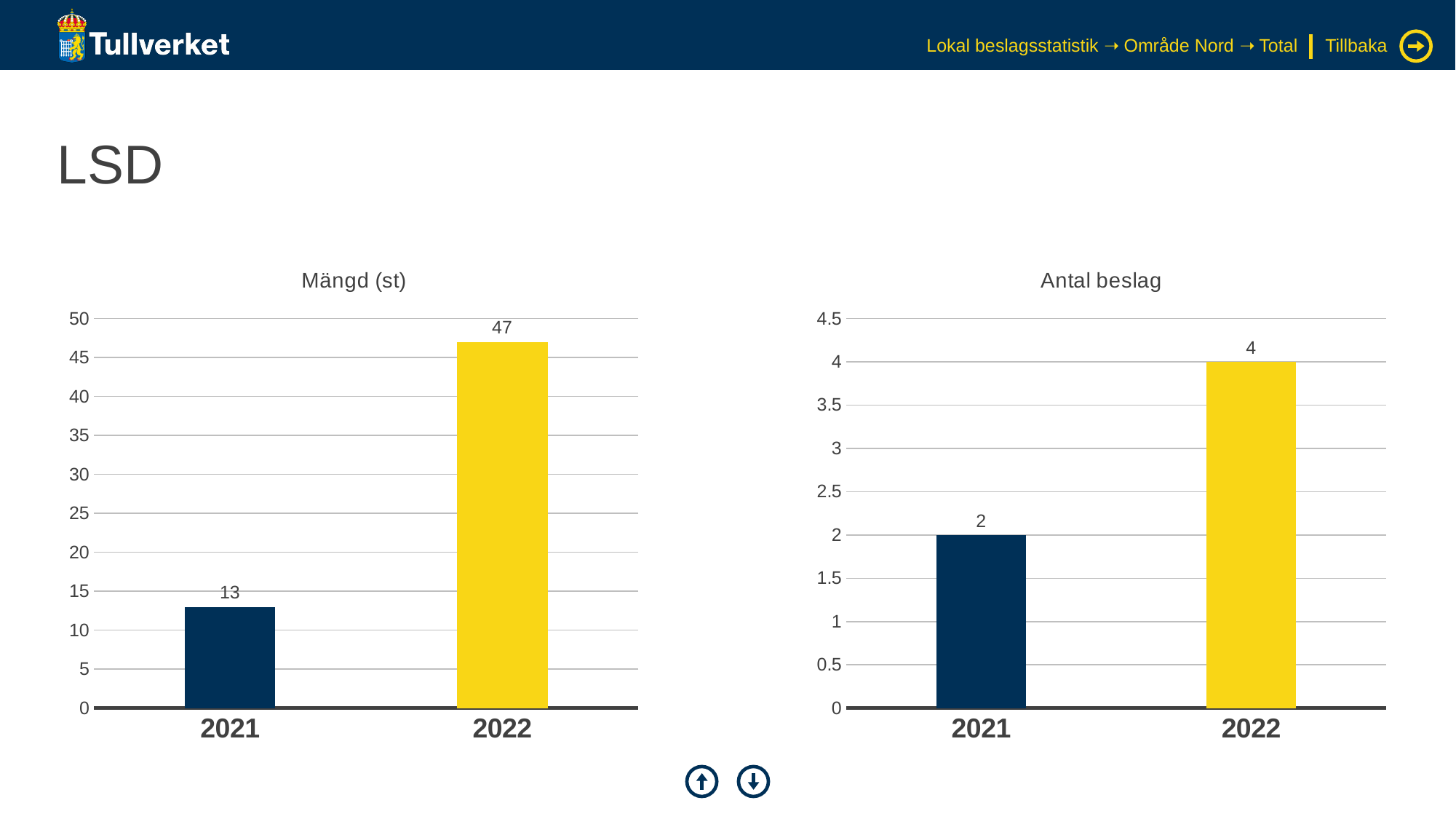
In the 'Antal beslag' chart, what is the value for 2022? 4 How many years are shown in the 'Mängd (st)' chart? 2 In the 'Mängd (st)' chart, what is the difference between the values for 2022 and 2021? 34 In the 'Antal beslag' chart, what is the difference between the values for 2022 and 2021? 2 In the 'Antal beslag' chart, which year has the lowest value? 2021 In the 'Antal beslag' chart, what is the value for 2021? 2 In the 'Mängd (st)' chart, what is the value for 2021? 13 In the 'Mängd (st)' chart, do the values rise or fall from 2021 to 2022? rise What kind of chart is the 'Antal beslag' chart? bar chart In the 'Antal beslag' chart, which is larger, the value for 2021 or 2022? 2022 In the 'Mängd (st)' chart, which year has the highest value? 2022 In the 'Mängd (st)' chart, what is the value for 2022? 47